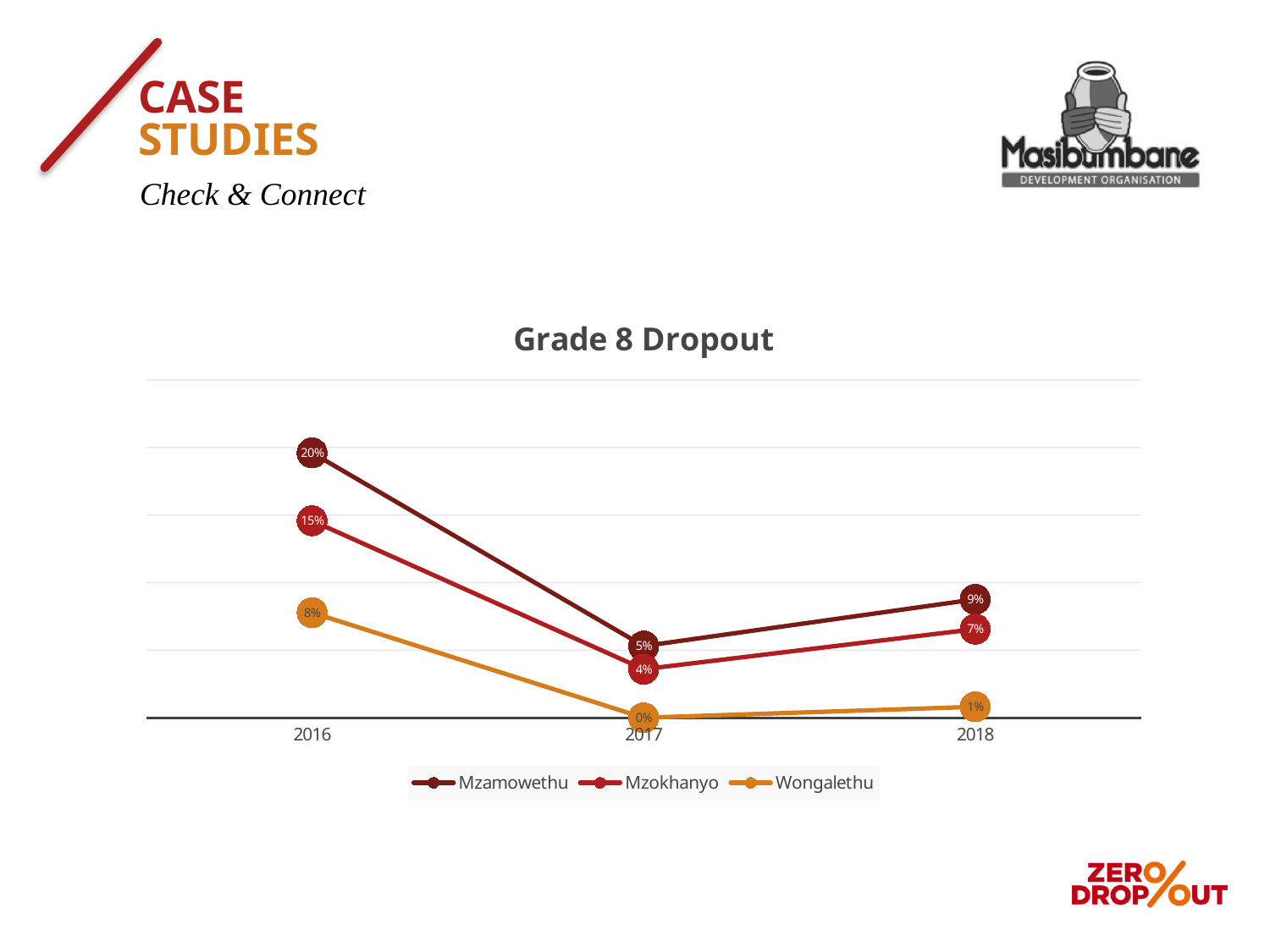
What is the Grade 8 dropout rate for Wongalethu in 2016? 8% What is the Grade 8 dropout rate for Mzamowethu in 2016? 20% What is the Grade 8 dropout rate for Wongalethu in 2018? 1% What kind of chart is the Grade 8 Dropout chart? Line chart Which is larger: Mzamowethu's dropout rate in 2018 or Mzokhanyo's dropout rate in 2018? Mzamowethu's dropout rate in 2018 Which school had the lowest Grade 8 dropout rate in 2017? Wongalethu Which school had the highest Grade 8 dropout rate in 2016? Mzamowethu How many series does the legend of the Grade 8 Dropout chart list? 3 Did Wongalethu's Grade 8 dropout rate rise or fall from 2016 to 2017? Fall How many years are shown on the x axis of the Grade 8 Dropout chart? 3 What is the Grade 8 dropout rate for Mzokhanyo in 2017? 4% What is the difference between Mzamowethu's and Mzokhanyo's Grade 8 dropout rates in 2016? 5%